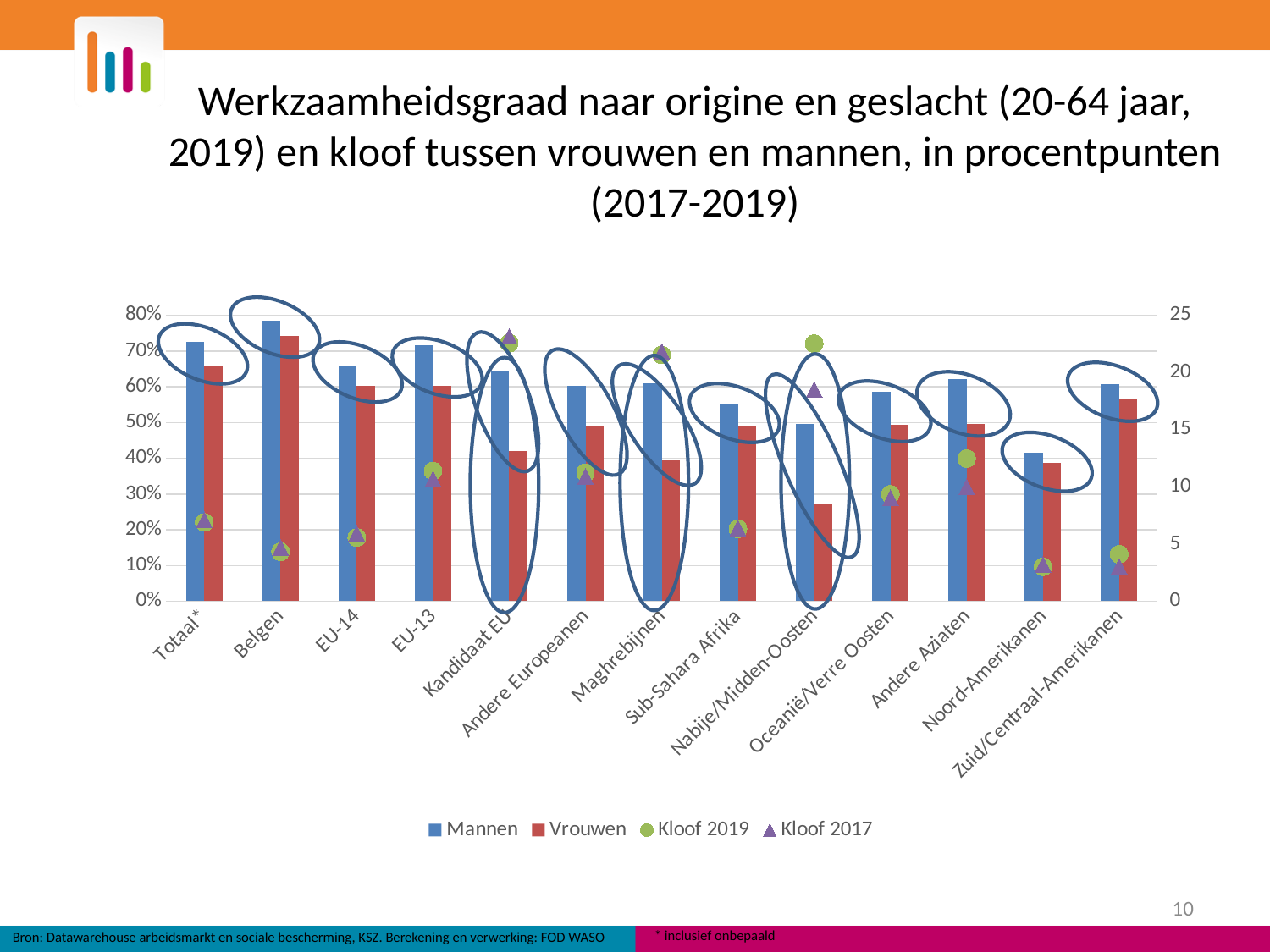
What kind of chart is shown on the slide? combination bar and line chart (bars with markers) Which is larger: the Vrouwen value for Belgen or the Vrouwen value for Maghrebijnen? Belgen Which category has the lowest value for Vrouwen? Nabije/Midden-Oosten Is the Mannen value for Belgen greater or less than 70%? greater Which category has the lowest value for Mannen? Noord-Amerikanen Is the Kloof 2019 value for Kandidaat EU greater or less than 20 on the right axis? greater Which category has the highest value for Mannen? Belgen How many series does the legend list? 4 Is the Vrouwen value for Nabije/Midden-Oosten greater or less than 30%? less How many origin categories are shown on the x axis? 13 Which legend entry is shown with a triangle marker? Kloof 2017